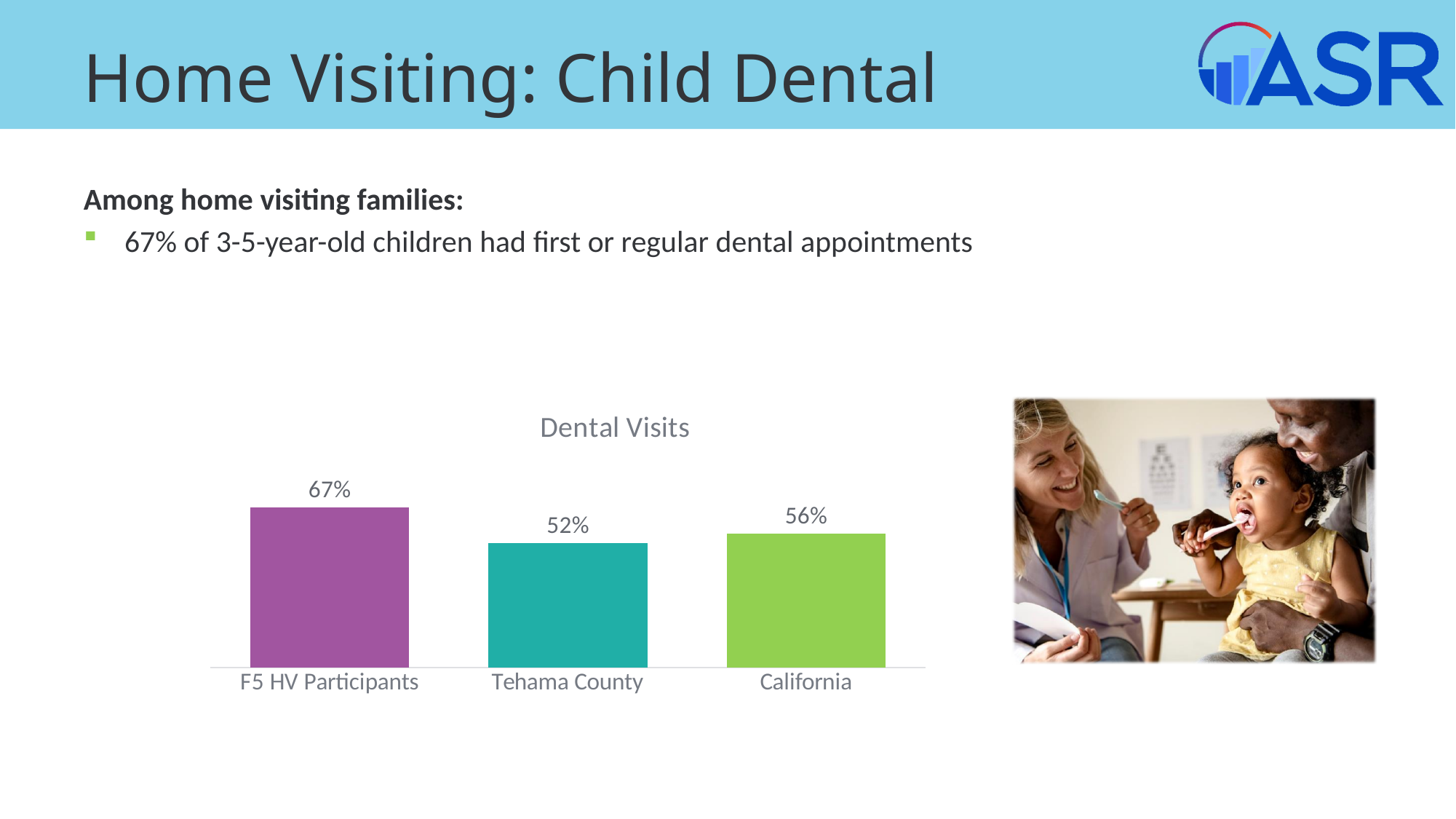
What colour is the bar for F5 HV Participants in the Dental Visits chart? Purple What is the value for F5 HV Participants in the Dental Visits chart? 67% Which category has the lowest value in the Dental Visits chart? Tehama County What kind of chart is the Dental Visits chart? Bar chart What is the title of the chart on the slide? Dental Visits What is the difference between the F5 HV Participants value and the Tehama County value in the Dental Visits chart? 15% How many categories are shown in the Dental Visits chart? 3 What is the value for California in the Dental Visits chart? 56% What is the value for Tehama County in the Dental Visits chart? 52% Which is larger in the Dental Visits chart, the value for California or the value for Tehama County? California What is the difference between the California value and the Tehama County value in the Dental Visits chart? 4% Which category has the highest value in the Dental Visits chart? F5 HV Participants